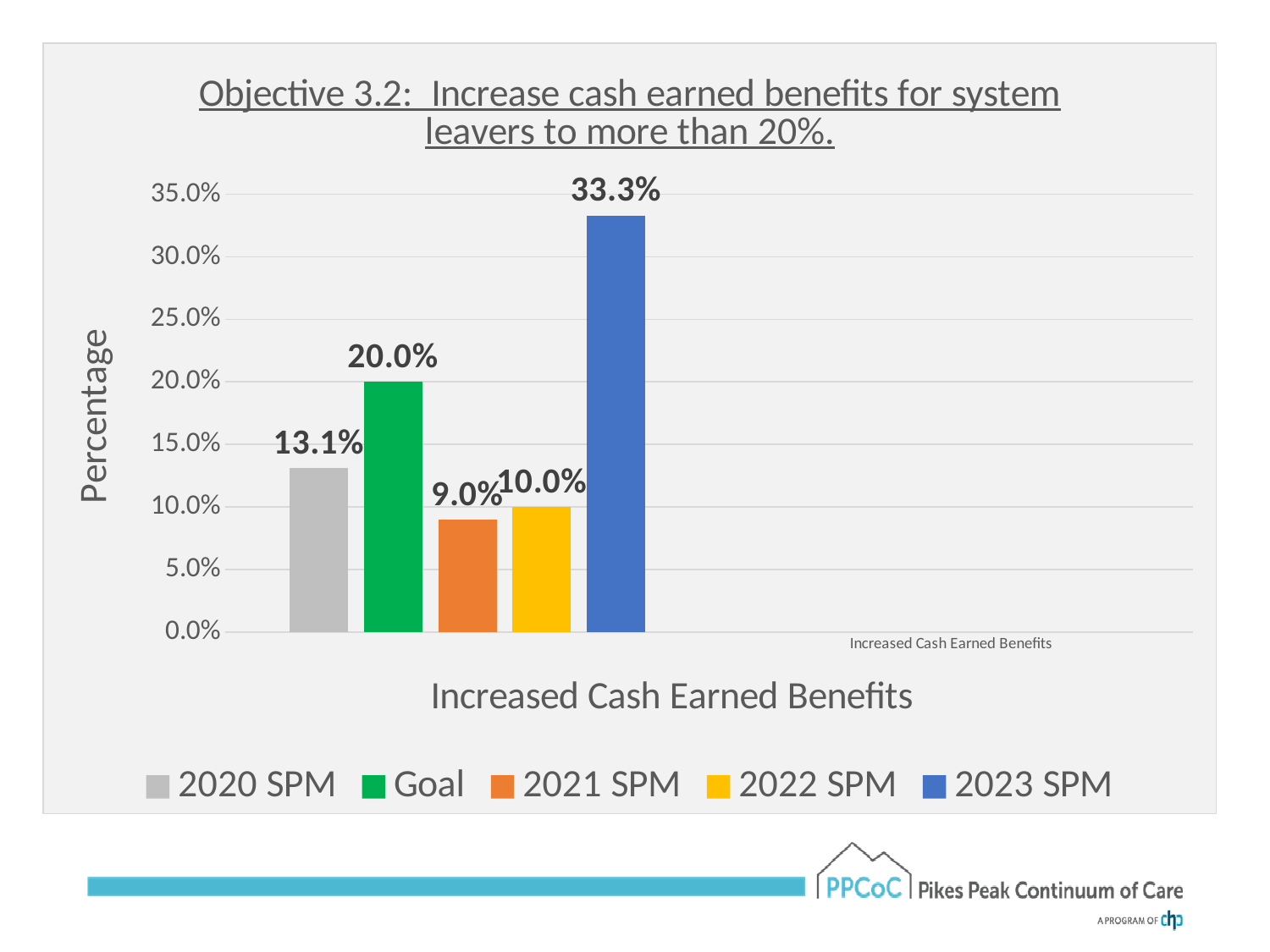
What kind of chart is shown on the slide? bar chart Which is larger, the value for 2020 SPM or the value for 2022 SPM? 2020 SPM What is the value for 2021 SPM? 9.0% What is the value for the Goal series? 20.0% Is the value for 2022 SPM greater or less than 15.0%? less How many series does the legend list? 5 What is the value for 2020 SPM? 13.1% What is the value for 2023 SPM? 33.3% What is the label on the vertical axis? Percentage Which series has the highest value? 2023 SPM What is the difference between the 2023 SPM value and the Goal value? 13.3% Which series has the lowest value? 2021 SPM